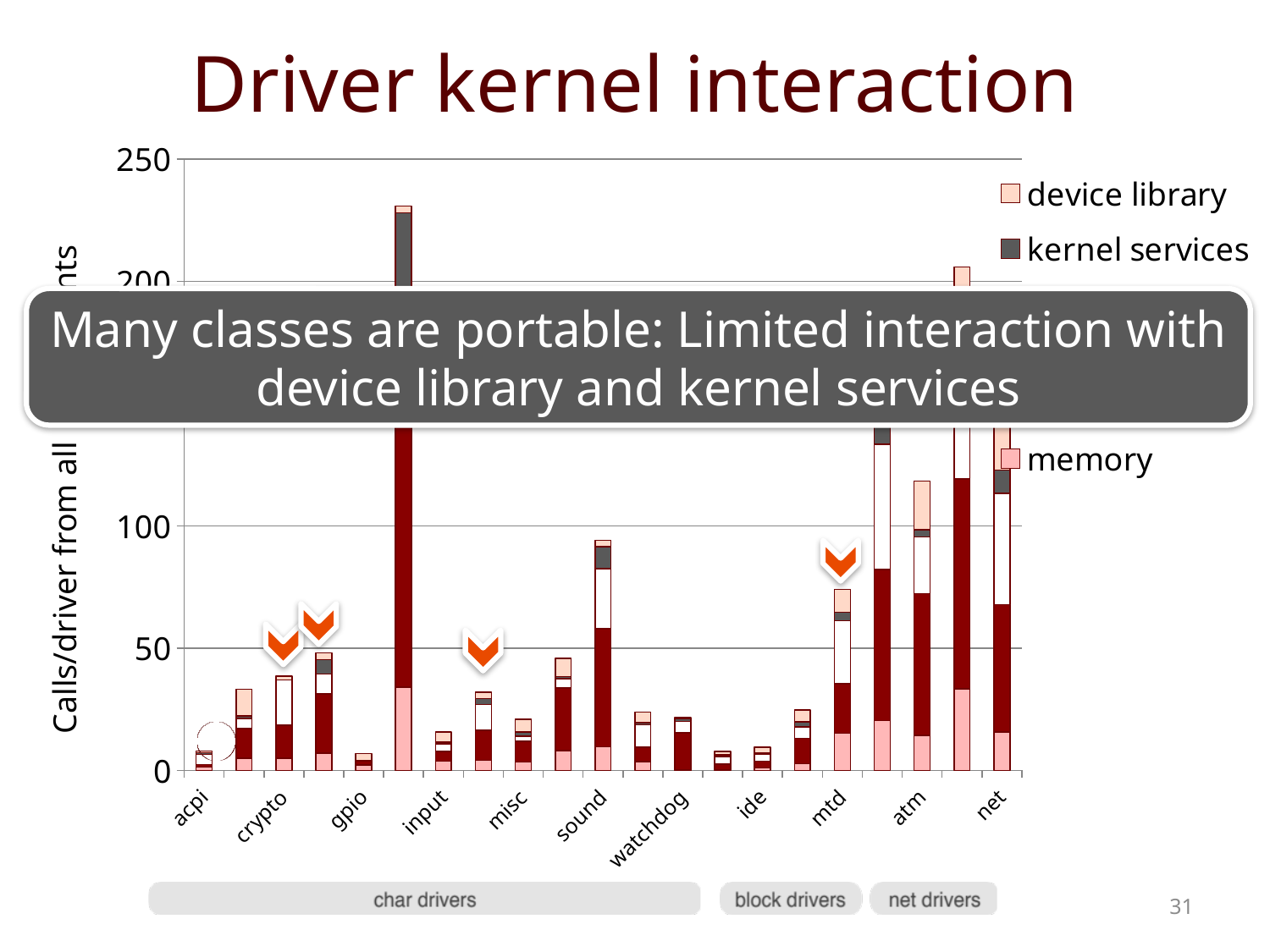
What is the title of the chart? Driver kernel interaction Is the total value for gpio greater or less than 50? less What type of chart is shown on the slide? stacked bar chart Which has a larger total value, sound or misc? sound Is the total value for net greater or less than 100? greater Which has a larger total value, crypto or gpio? crypto Is the total value for sound greater or less than 100? less Which legend entry is listed first (at the top) in the chart legend? device library